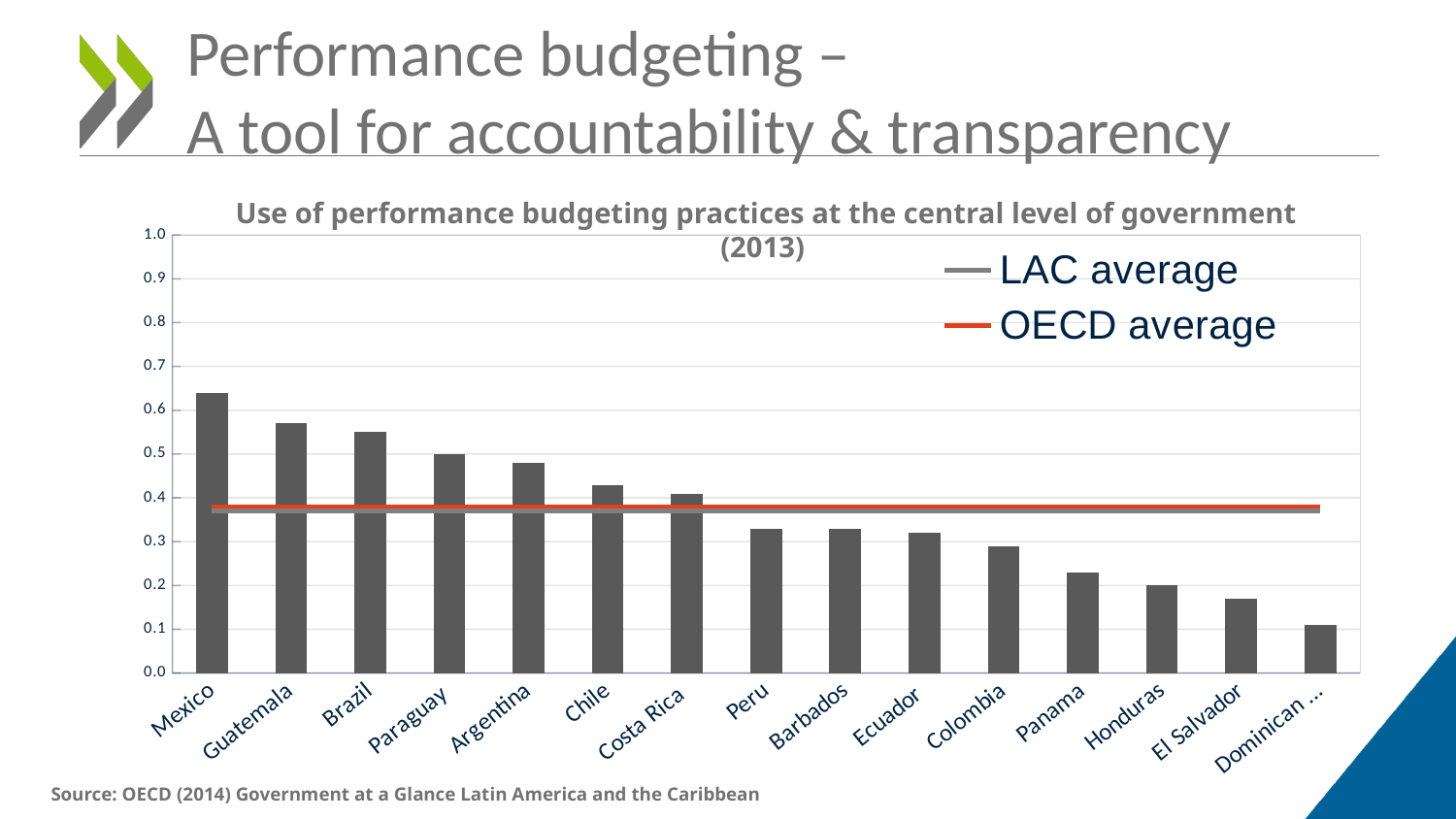
Is the value for Guatemala greater or less than 0.5? greater Do the bar values rise or fall from left to right along the x axis? fall Is the value for El Salvador greater or less than 0.2? less How many entries does the legend list? 2 Which country has the highest value in the chart? Mexico Is the value for Peru greater or less than 0.4? less What kind of chart is shown on the slide? bar chart How many countries are shown on the x axis? 15 Which country has the lowest value in the chart? Dominican ... What is the title of the chart? Use of performance budgeting practices at the central level of government (2013) Which has a larger value, Brazil or Chile? Brazil